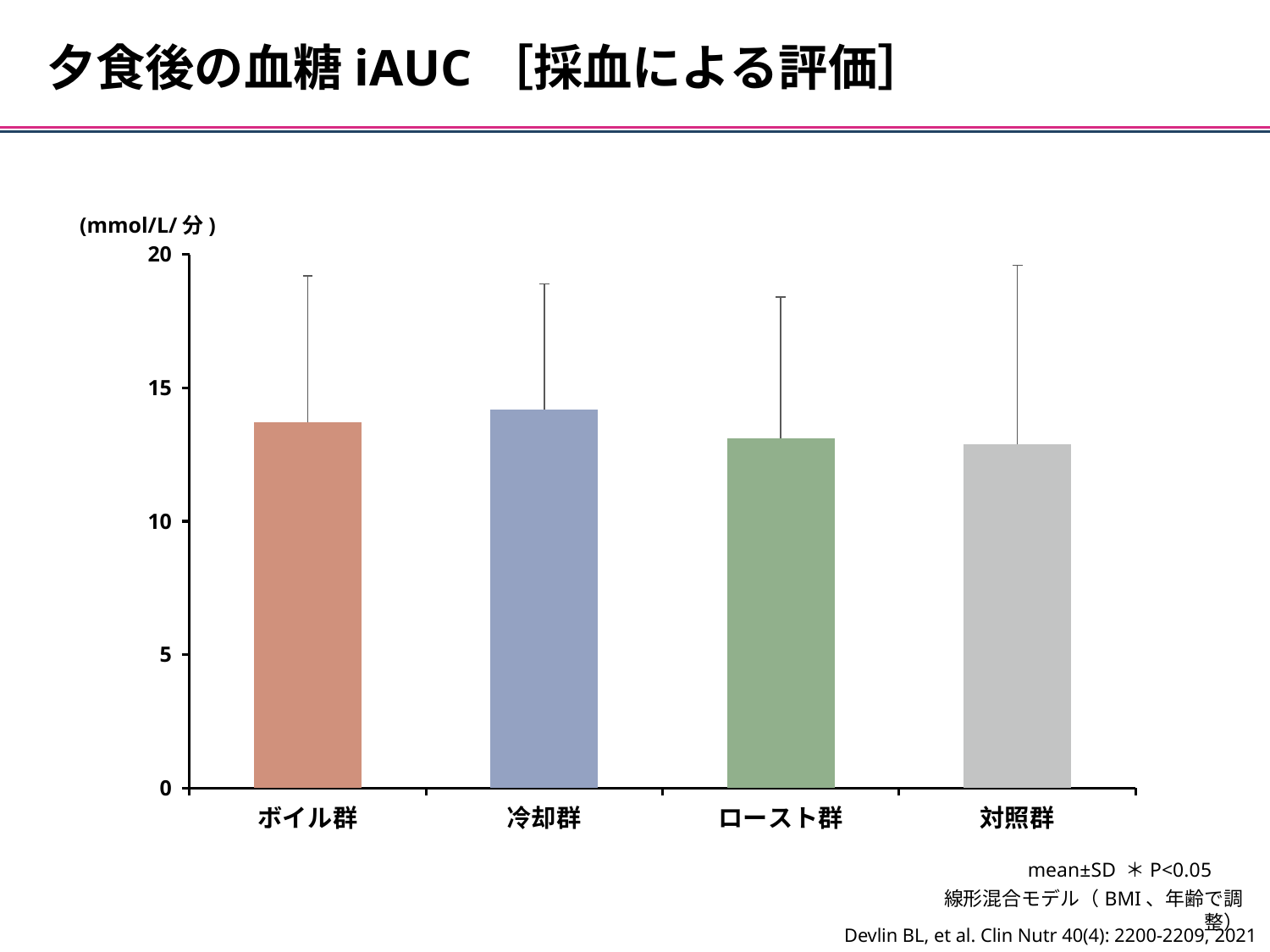
Which bar is taller, 冷却群 or 対照群? 冷却群 What unit is shown on the y axis of the chart? (mmol/L/分) Which group has the highest bar in the chart? 冷却群 What kind of chart is shown on the slide? bar chart How many groups (bars) are plotted in the chart? 4 Is the value for ボイル群 greater or less than 15? less Is the value for ロースト群 greater or less than 10? greater Is the value for 対照群 greater or less than 10? greater What is the label of the fourth (rightmost) bar in the chart? 対照群 What is the maximum value shown on the y axis of the chart? 20 Which bar is taller, ボイル群 or ロースト群? ボイル群